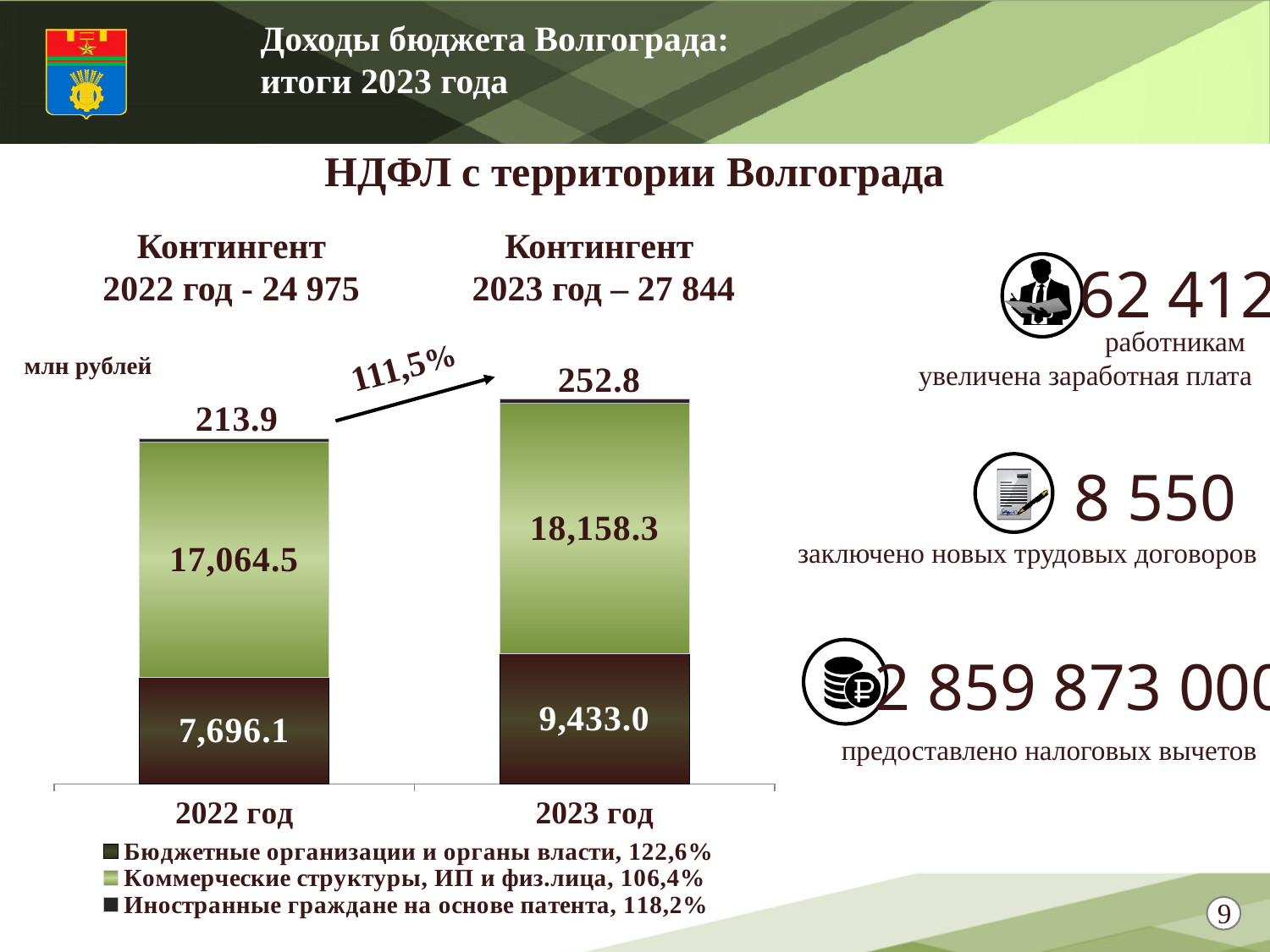
What is the value for Иностранные граждане на основе патента in 2022 год? 213.9 How many series does the chart legend list? 3 What is the difference between the Иностранные граждане на основе патента values for 2023 год and 2022 год? 38.9 What is the value for Бюджетные организации и органы власти in 2022 год? 7,696.1 How many categories (years) are shown on the x axis of the chart? 2 By how much did the value for Бюджетные организации и органы власти increase from 2022 год to 2023 год? 1,736.9 What growth percentage is shown on the arrow between the 2022 and 2023 bars? 111,5% Which series has the largest value in 2023 год? Коммерческие структуры, ИП и физ.лица What type of chart is shown on the slide? stacked bar chart What is the value for Коммерческие структуры, ИП и физ.лица in 2023 год? 18,158.3 What is the value for Бюджетные организации и органы власти in 2023 год? 9,433.0 Which is larger: Коммерческие структуры, ИП и физ.лица in 2022 год or in 2023 год? 2023 год